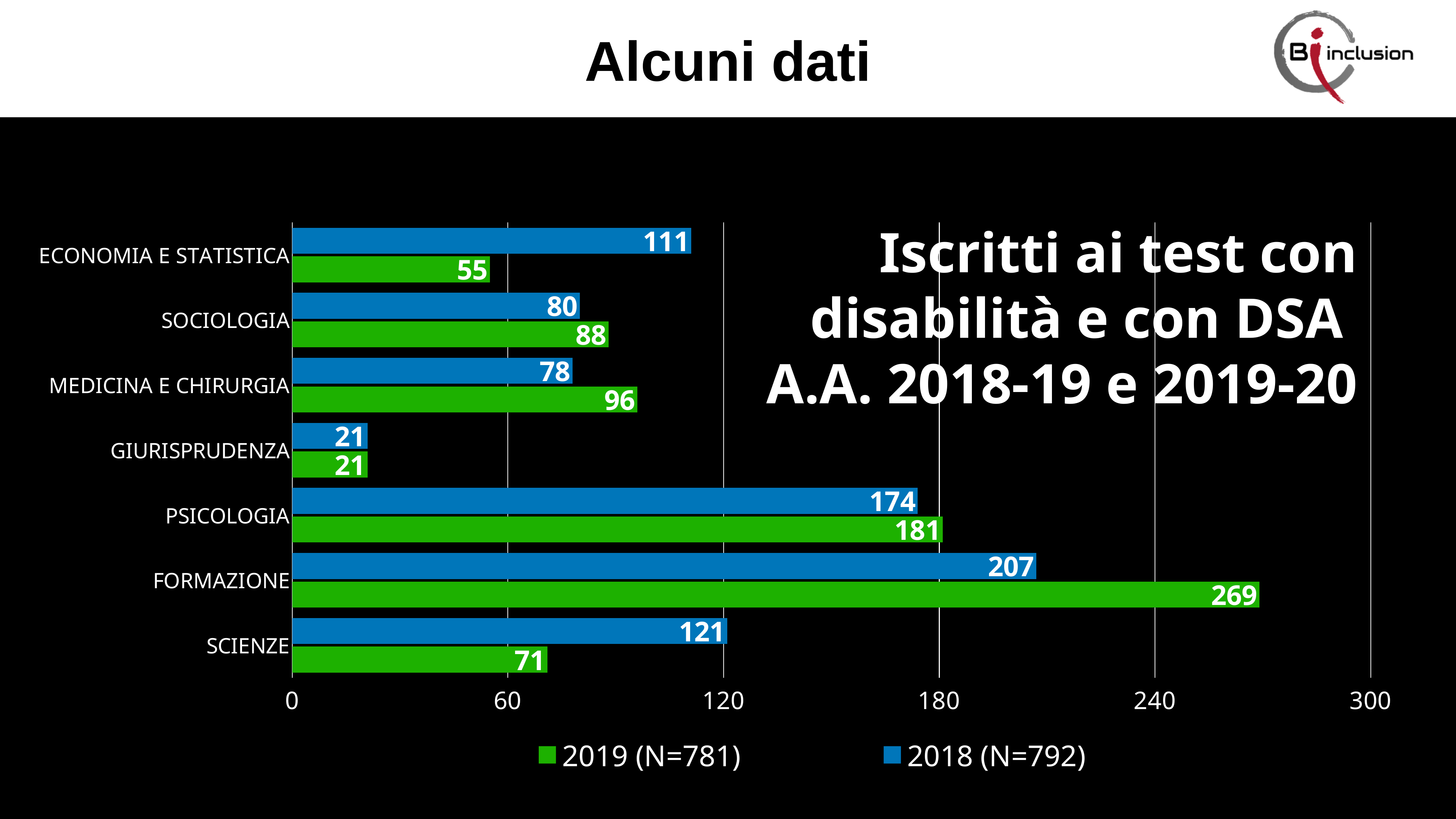
How many series does the legend list? 2 What is the 2019 (N=781) value for FORMAZIONE? 269 Which category has the lowest 2018 (N=792) value? GIURISPRUDENZA Which is larger for ECONOMIA E STATISTICA, the 2019 value or the 2018 value? 2018 Which category has the highest 2019 (N=781) value? FORMAZIONE What is the difference between the 2019 and 2018 values for FORMAZIONE? 62 What kind of chart is shown on the slide? Bar chart What is the difference between the 2018 and 2019 values for SCIENZE? 50 How many categories are shown on the chart? 7 Which is larger for PSICOLOGIA, the 2019 (N=781) value or the 2018 (N=792) value? 2019 (N=781) What is the 2018 (N=792) value for ECONOMIA E STATISTICA? 111 What is the 2018 (N=792) value for SCIENZE? 121